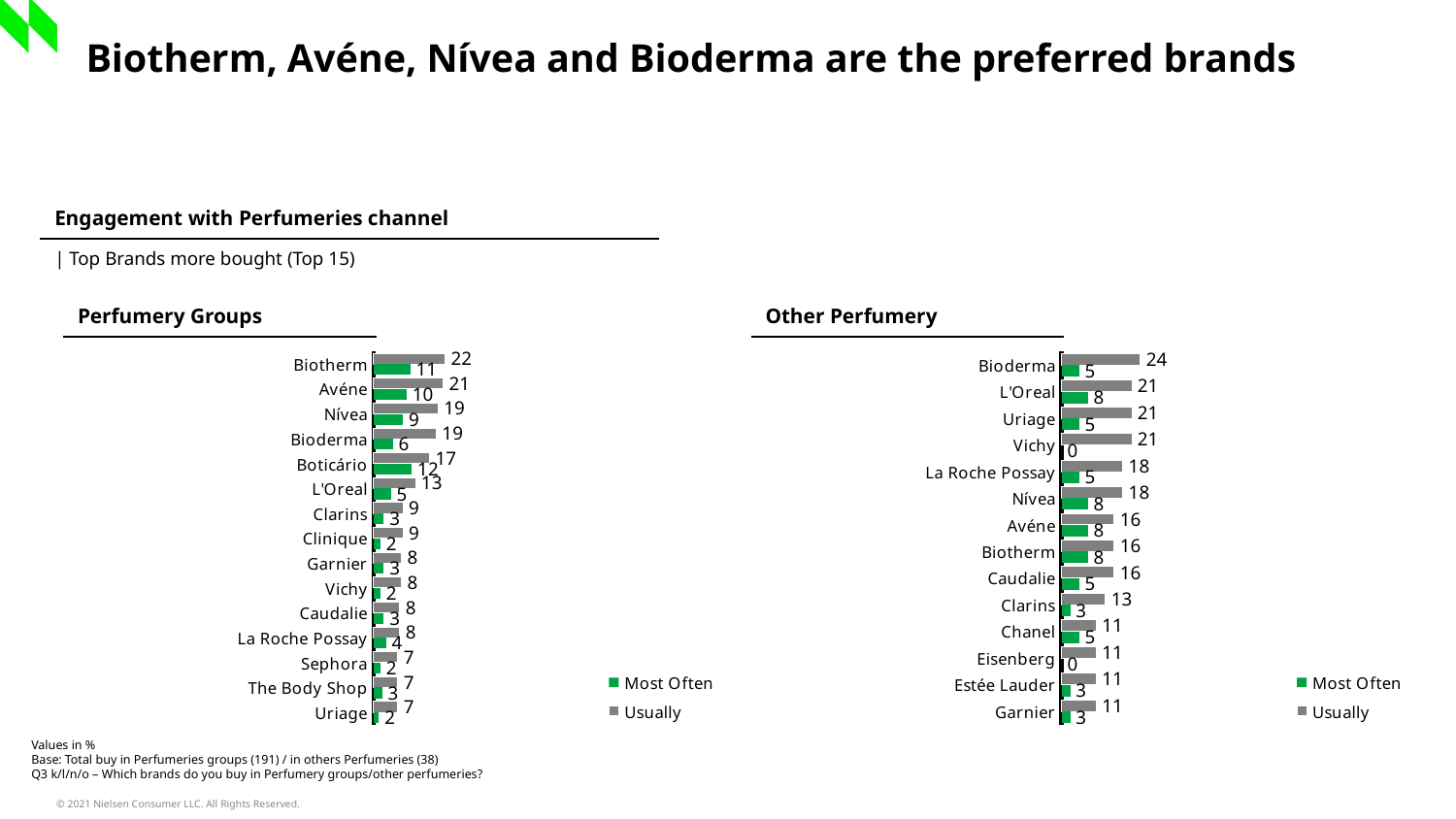
In the Perfumery Groups chart, which brand has the highest Most Often value? Boticário In the Other Perfumery chart, what is the Usually value for Bioderma? 24 In the Perfumery Groups chart, what is the Most Often value for Boticário? 12 How many brands are shown in the Other Perfumery chart? 14 In the Perfumery Groups chart, what is the difference between the Usually values for Biotherm and L'Oreal? 9 In the Perfumery Groups chart, what is the Usually value for Biotherm? 22 In the Other Perfumery chart, what is the Most Often value for Vichy? 0 What type of chart is the Other Perfumery chart? Bar chart In the Other Perfumery chart, which is larger, the Usually value for L'Oreal or for Clarins? L'Oreal In the Other Perfumery chart, which brand has the highest Usually value? Bioderma How many brands are shown in the Perfumery Groups chart? 15 How many series does the legend of the Perfumery Groups chart list? 2